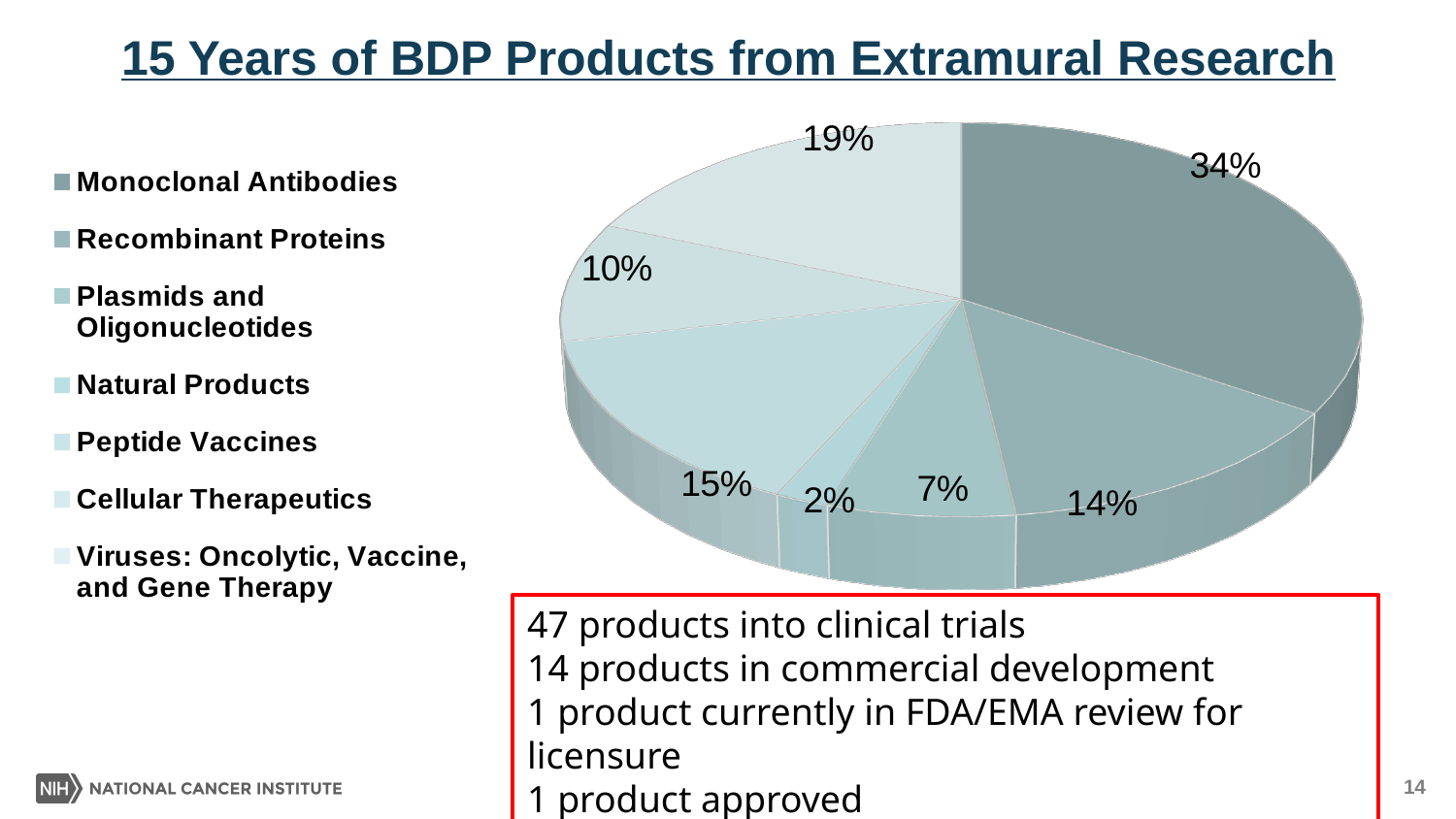
Which category has the largest slice of the pie chart? Monoclonal Antibodies What kind of chart is shown on the slide? pie chart What share of the pie is labelled for Viruses: Oncolytic, Vaccine, and Gene Therapy? 19% How many entries does the legend of the pie chart list? 7 How many slices does the pie chart have? 7 What is the smallest percentage shown on the pie chart? 2% What is the largest percentage shown on the pie chart? 34% Which is larger on the pie chart, the 10% slice or the 19% slice? the 19% slice What percentage is shown for Peptide Vaccines on the pie chart? 15% What is the difference between the largest slice (34%) and the 14% slice? 20% Which category has the smallest slice of the pie chart? Natural Products What is the title of the slide containing the pie chart? 15 Years of BDP Products from Extramural Research